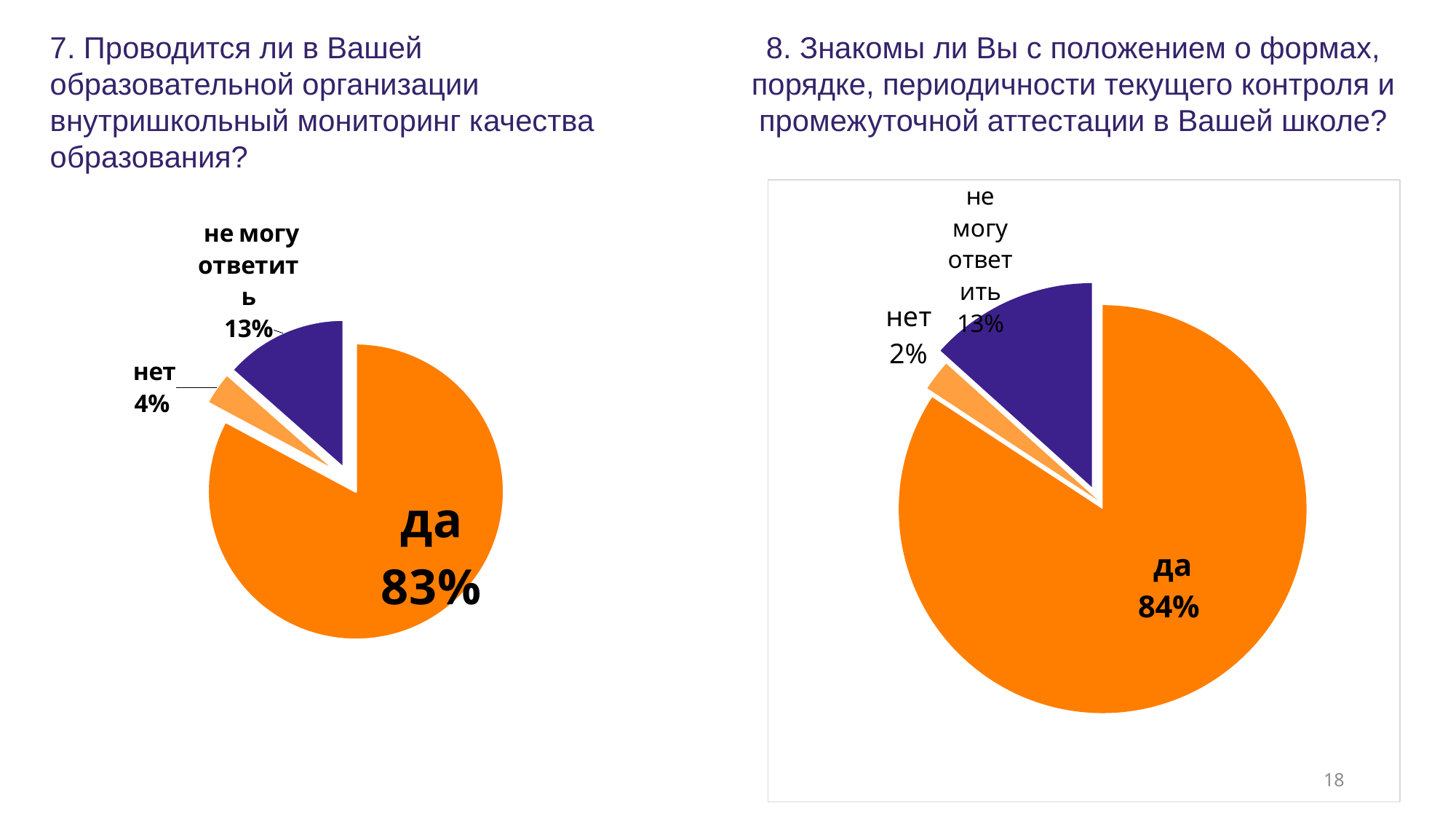
In the right pie chart (question 8), what share of respondents answered "не могу ответить"? 13% In the right pie chart (question 8), what share of respondents answered "нет"? 2% What type of chart is used for question 7 on the left? pie chart In the left pie chart (question 7), what share of respondents answered "не могу ответить"? 13% How many slices does the right pie chart (question 8) have? 3 In the left pie chart (question 7), what share of respondents answered "нет"? 4% In the left pie chart (question 7), what share of respondents answered "да"? 83% In the right pie chart (question 8), which answer has the largest share? да Which is larger: the "нет" share in the left chart (question 7) or the "нет" share in the right chart (question 8)? left chart (question 7), 4% In the left pie chart (question 7), what is the difference between the "да" share and the "не могу ответить" share? 70% In the right pie chart (question 8), what share of respondents answered "да"? 84% In the left pie chart (question 7), which answer has the smallest share? нет